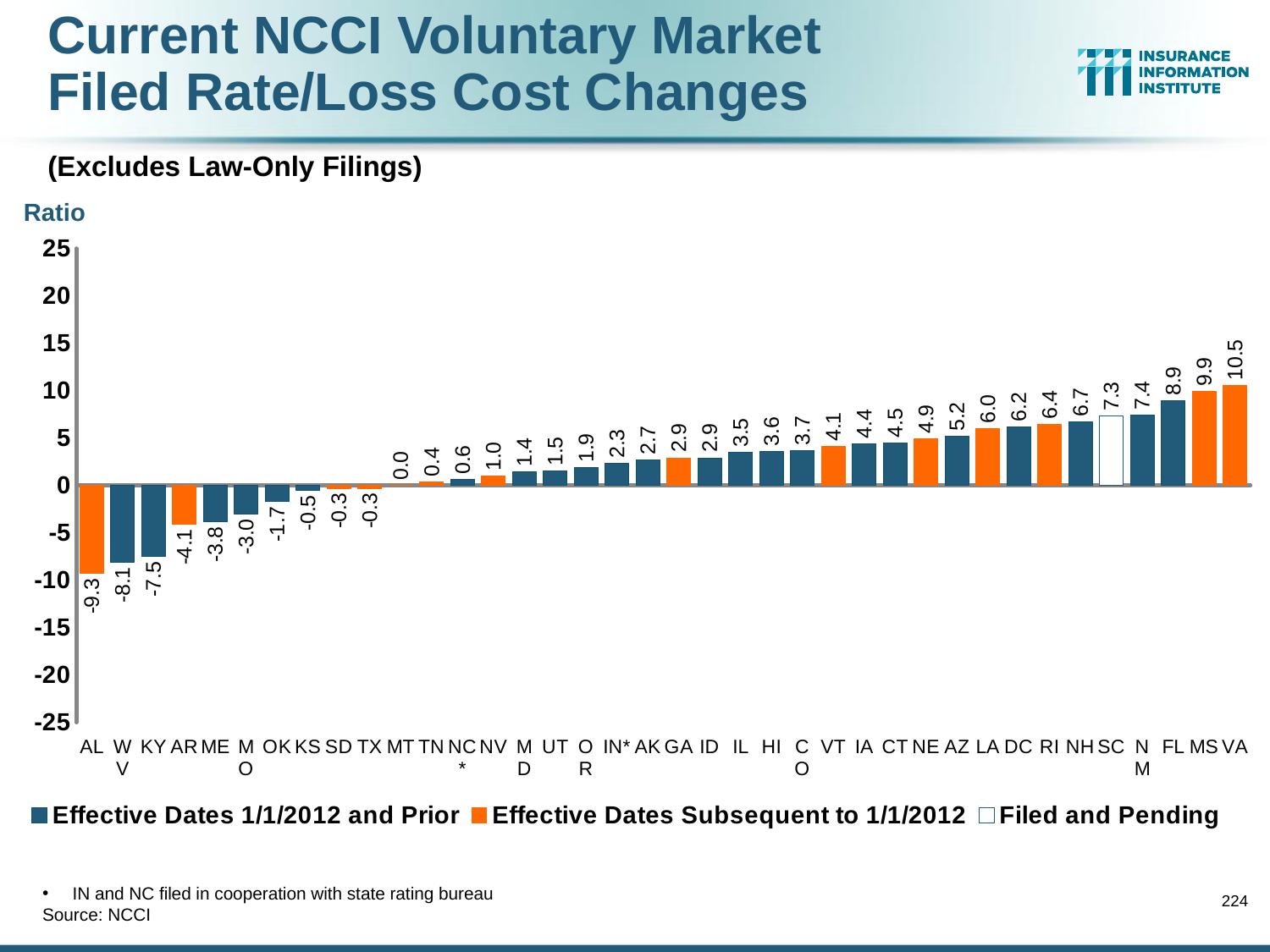
What is the difference between the values for VA and AL? 19.8 What is the value for SC? 7.3 Which state has the highest value? VA How many states are shown on the x axis? 38 Which has a larger value, FL or MS? MS What is the value for VA? 10.5 What is the value for AL? -9.3 Which state's bar belongs to the 'Filed and Pending' series? SC How many series does the legend list? 3 What kind of chart is this? bar chart Which state has the lowest value? AL Is the value for VA greater or less than 10? greater